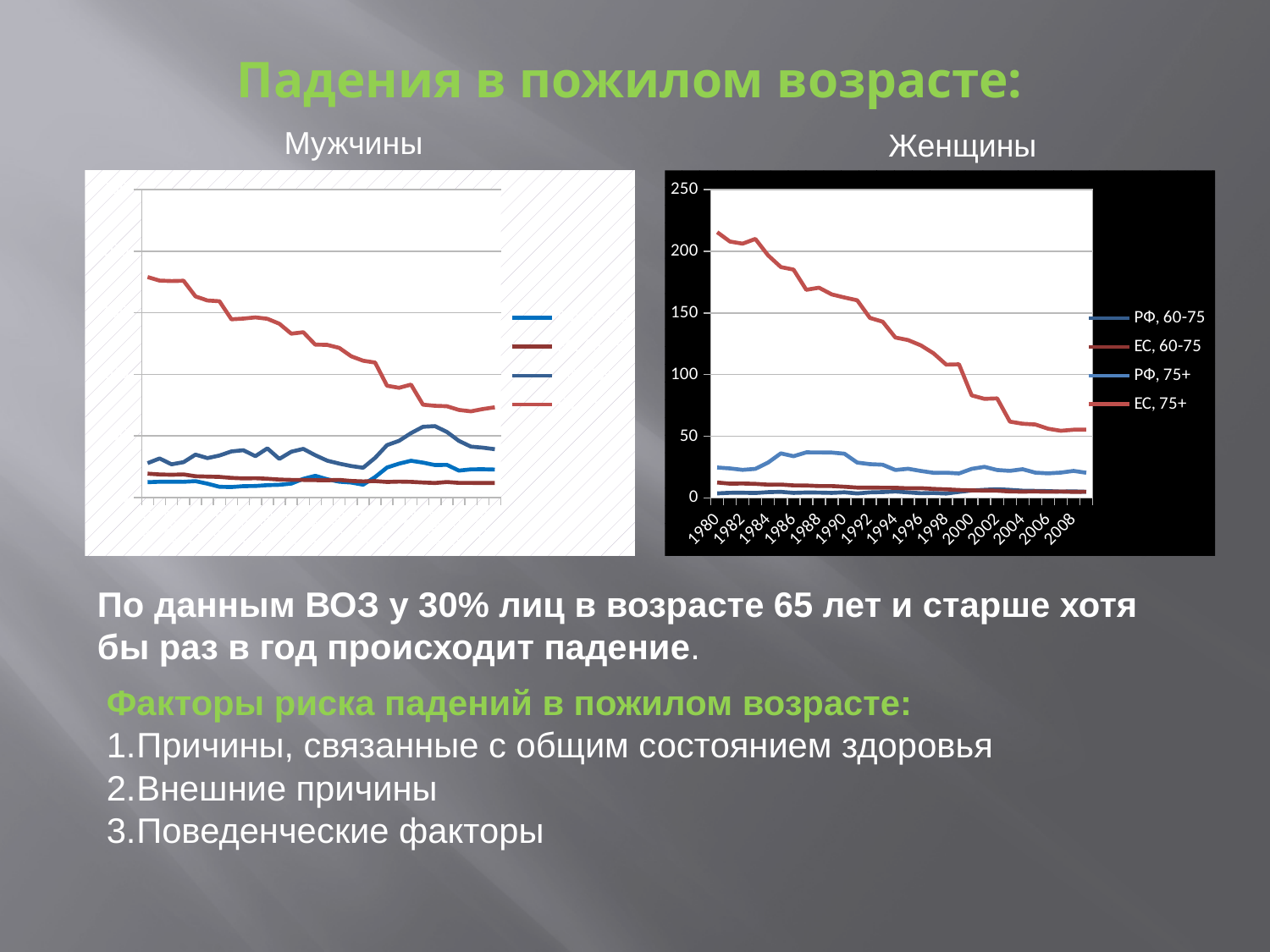
What kind of chart is the "Мужчины" chart on the left? line chart In the "Женщины" chart, how many series does the legend list? 4 In the "Женщины" chart, does the "ЕС, 75+" series rise or fall from 1980 to 2008? fall In the "Женщины" chart, is the value for "ЕС, 75+" in 1980 greater or less than 200? greater In the "Женщины" chart, which series has the highest values across the whole period? ЕС, 75+ In the "Женщины" chart, how many year labels are shown on the x axis? 15 In the "Женщины" chart, is the value for "ЕС, 75+" in 2008 greater or less than 100? less In the "Женщины" chart, which is larger in 1990: "ЕС, 75+" or "РФ, 75+"? ЕС, 75+ In the "Женщины" chart, is the value for "РФ, 75+" in 1988 greater or less than 50? less What are the titles of the two charts on the slide? Мужчины and Женщины What kind of chart is the "Женщины" chart on the right? line chart In the "Женщины" chart, what is the highest value shown on the y axis? 250